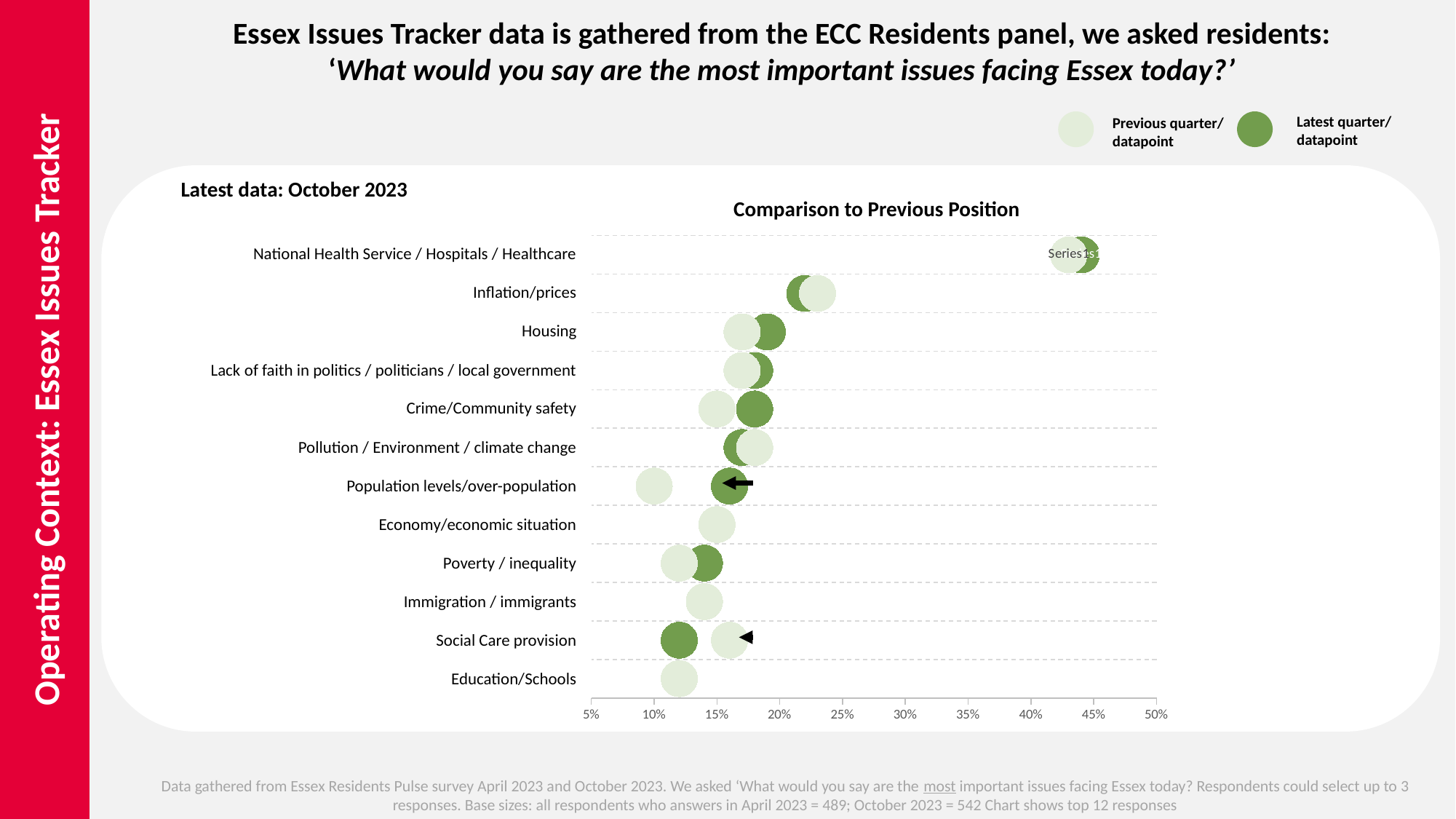
Is the latest quarter value for Inflation/prices greater or less than 20%? greater How many issue categories are plotted on the chart? 12 For Population levels/over-population, which is larger: the latest quarter value or the previous quarter value? Latest quarter Which issue has the highest value on the chart? National Health Service / Hospitals / Healthcare Is the latest quarter value for National Health Service / Hospitals / Healthcare greater or less than 40%? greater For Social Care provision, which is larger: the latest quarter value or the previous quarter value? Previous quarter What is the title of the chart? Comparison to Previous Position How many series does the chart legend list? 2 What kind of chart is shown on the slide? Dot chart Which has the larger latest quarter value, Inflation/prices or Housing? Inflation/prices Is the previous quarter value for Population levels/over-population greater or less than 15%? less